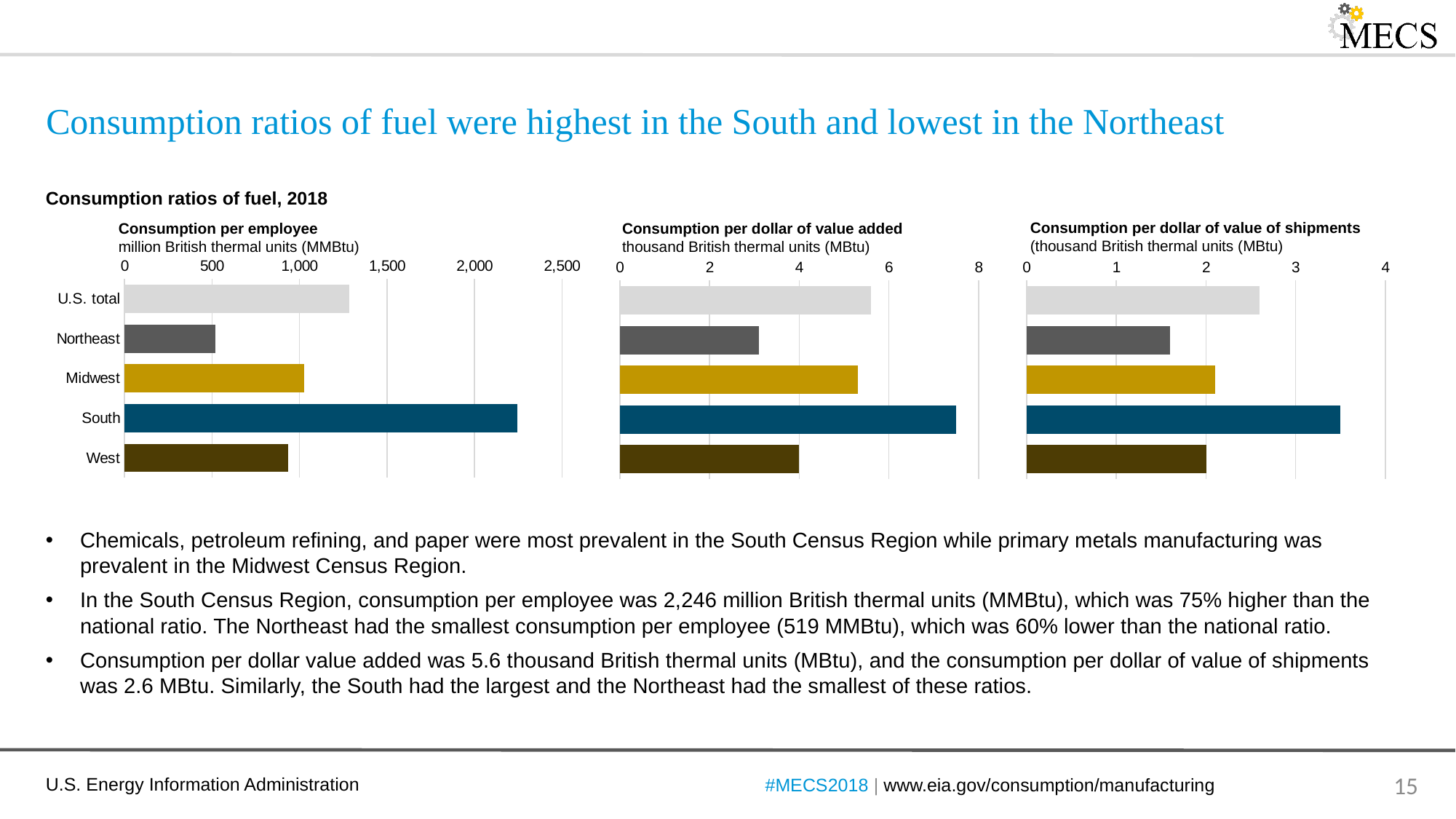
In the 'Consumption per employee' chart, is the value for the West greater or less than 1,000? less In the 'Consumption per employee' chart, which region has the lowest value? Northeast In the 'Consumption per employee' chart, is the value for the U.S. total greater or less than 1,000? greater How many categories are shown in the 'Consumption per dollar of value of shipments' chart? 5 In the 'Consumption per employee' chart, what is the value for the South? 2,246 MMBtu In the 'Consumption per employee' chart, which region has the highest value? South In the 'Consumption per dollar of value added' chart, which is larger, the Midwest or the West? Midwest In the 'Consumption per dollar of value added' chart, which region has the highest value? South In the 'Consumption per employee' chart, what is the value for the Northeast? 519 MMBtu In the 'Consumption per dollar of value added' chart, is the value for the Northeast greater or less than 4? less What kind of chart is used for 'Consumption per employee'? bar chart